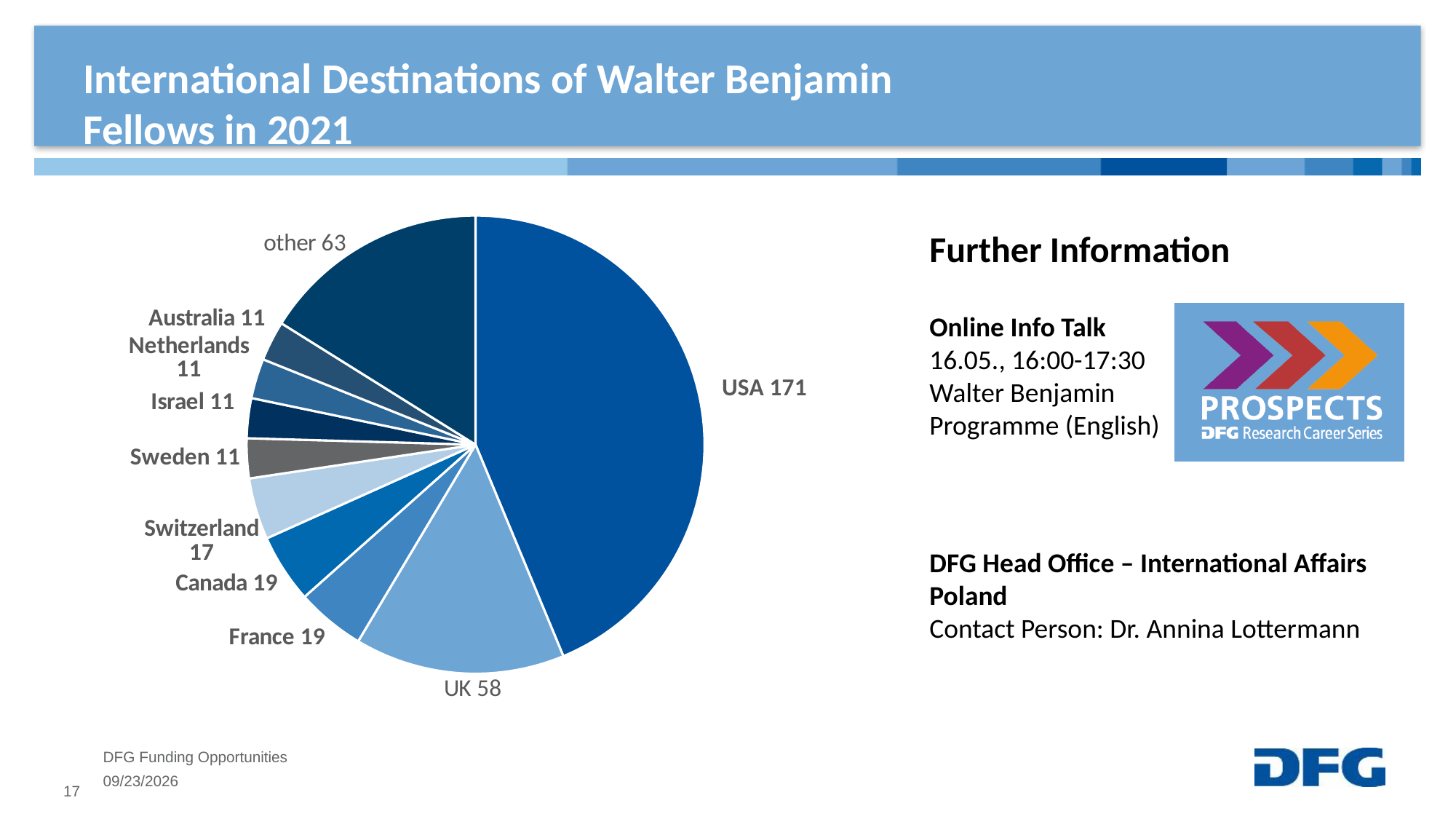
What is the difference between the 'other' value and the UK value in the pie chart? 5 Which is larger in the pie chart, the value for the UK or the value for 'other'? other What type of chart is shown on the slide? pie chart How many slices does the pie chart have? 10 Which is larger in the pie chart, the value for Canada or the value for Switzerland? Canada What is the title of the slide containing the pie chart? International Destinations of Walter Benjamin Fellows in 2021 What is the value shown for the UK in the pie chart? 58 What is the difference between the USA value and the UK value in the pie chart? 113 What value is shown for Switzerland in the pie chart? 17 How many fellows went to the USA according to the pie chart? 171 Which destination has the largest slice in the pie chart? USA What value is shown for the 'other' slice of the pie chart? 63